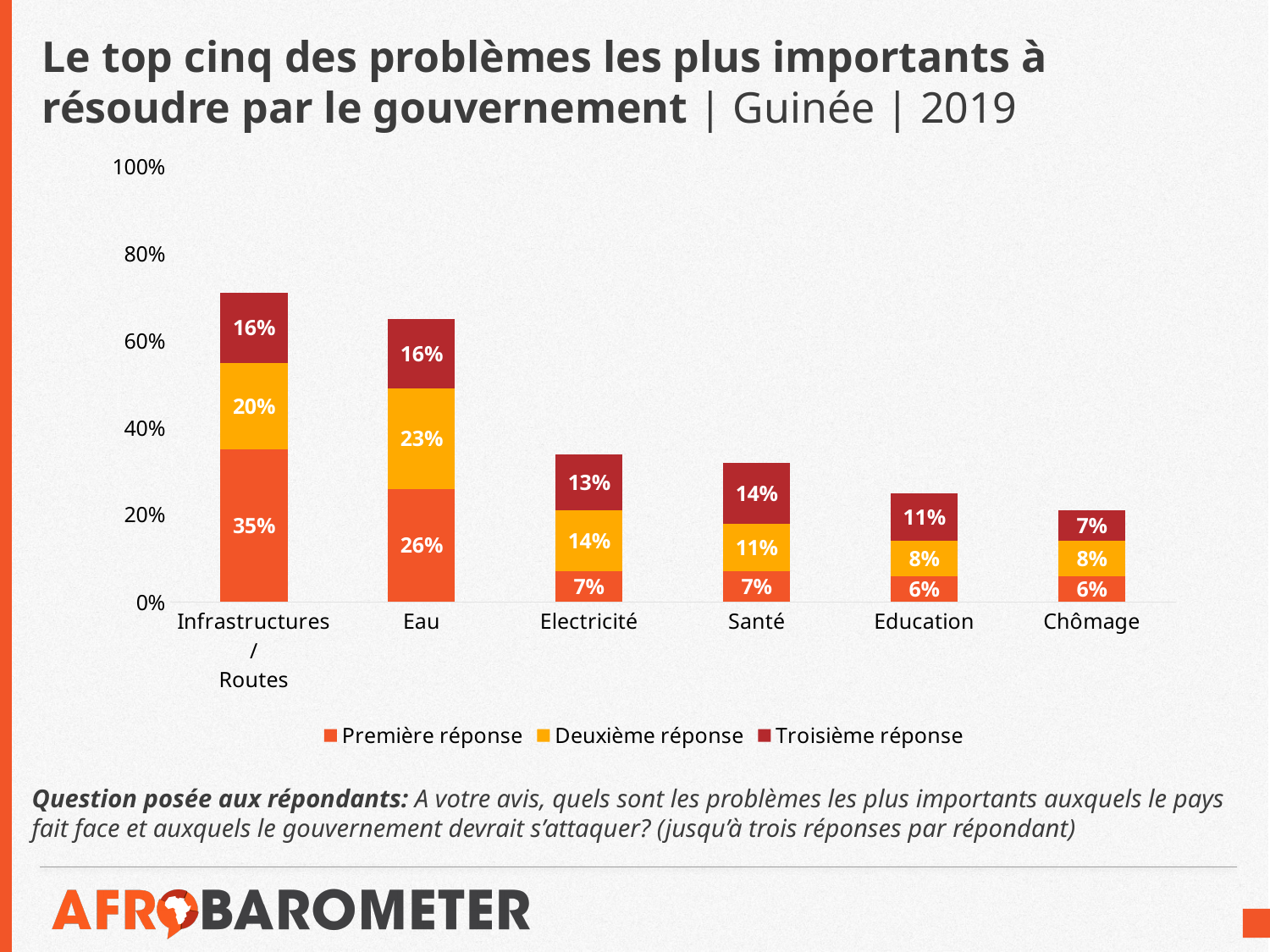
What is the total of the stacked bar for Chômage? 21% What is the difference between the 'Première réponse' values for Infrastructures / Routes and Eau? 9% Which is larger: the 'Deuxième réponse' value for Electricité or for Santé? Electricité What kind of chart is shown on the slide? Stacked bar chart How many categories are shown on the x axis? 6 What is the 'Troisième réponse' value for Santé? 14% Which category has the highest 'Première réponse' value? Infrastructures / Routes How many series does the legend list? 3 What is the 'Deuxième réponse' value for Eau? 23% What is the 'Première réponse' value for Infrastructures / Routes? 35% Which category has the lowest 'Troisième réponse' value? Chômage What is the total of the stacked bar for Eau? 65%